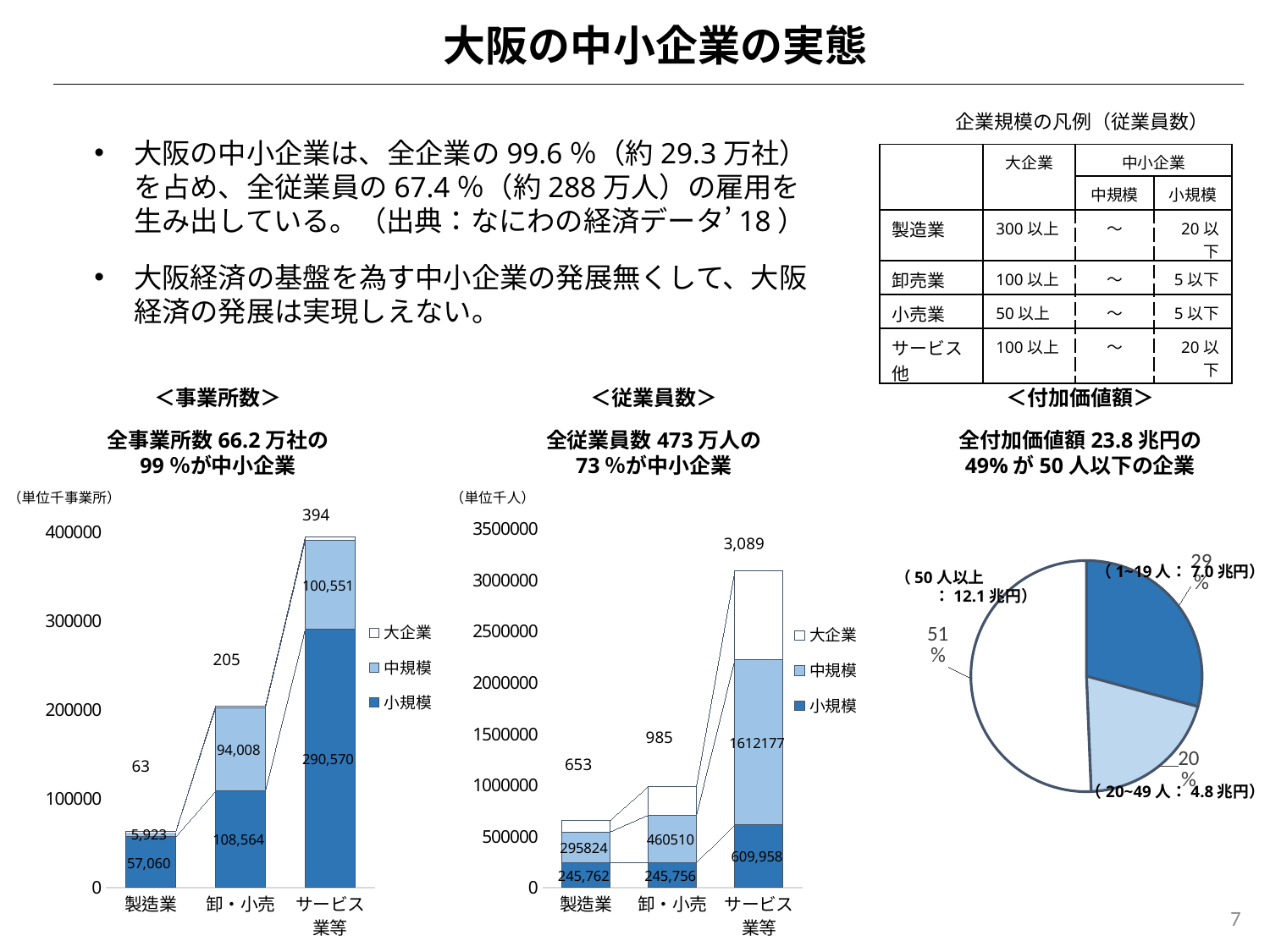
In the ＜従業員数＞ chart, which category has the shortest stacked bar? 製造業 In the ＜付加価値額＞ pie chart, what share does the 20~49人 slice have? 20% In the ＜付加価値額＞ pie chart, what value is shown for 50人以上? 12.1兆円 In the ＜従業員数＞ chart, is the total for サービス業等 greater or less than 3000000? greater How many categories are shown on the x axis of the ＜事業所数＞ chart? 3 In the ＜事業所数＞ chart, which category has the tallest stacked bar? サービス業等 In the ＜従業員数＞ chart, what is the value of 中規模 for 卸・小売? 460510 In the ＜従業員数＞ chart, which is larger for 製造業: 中規模 or 小規模? 中規模 In the ＜事業所数＞ chart, what is the difference between 小規模 and 中規模 for 卸・小売? 14,556 In the ＜事業所数＞ chart, what is the value of 小規模 for サービス業等? 290,570 How many series does the legend of the ＜従業員数＞ chart list? 3 What kind of chart is the ＜付加価値額＞ chart? pie chart